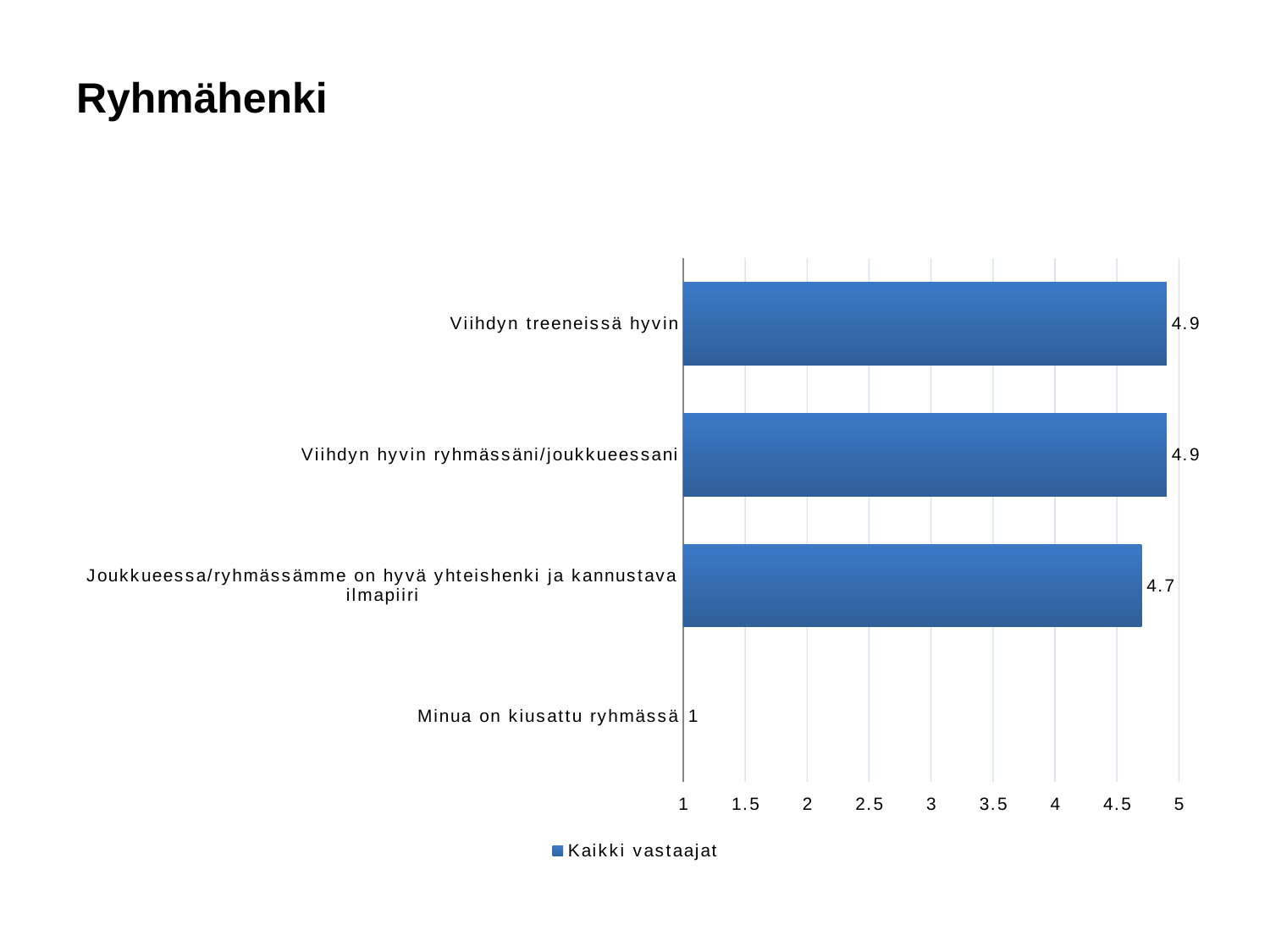
What is the value for "Joukkueessa/ryhmässämme on hyvä yhteishenki ja kannustava ilmapiiri"? 4.7 What is the value for "Viihdyn hyvin ryhmässäni/joukkueessani"? 4.9 What is the value for "Minua on kiusattu ryhmässä"? 1 Which is larger: the value for "Viihdyn treeneissä hyvin" or the value for "Minua on kiusattu ryhmässä"? Viihdyn treeneissä hyvin Which category has the lowest value? Minua on kiusattu ryhmässä What is the difference between the values for "Viihdyn treeneissä hyvin" and "Joukkueessa/ryhmässämme on hyvä yhteishenki ja kannustava ilmapiiri"? 0.2 What kind of chart is shown on the slide? Bar chart How many series does the legend list? 1 Is the value for "Joukkueessa/ryhmässämme on hyvä yhteishenki ja kannustava ilmapiiri" greater or less than 4? greater What is the difference between the values for "Viihdyn hyvin ryhmässäni/joukkueessani" and "Minua on kiusattu ryhmässä"? 3.9 What is the value for "Viihdyn treeneissä hyvin"? 4.9 How many categories are shown in the chart? 4